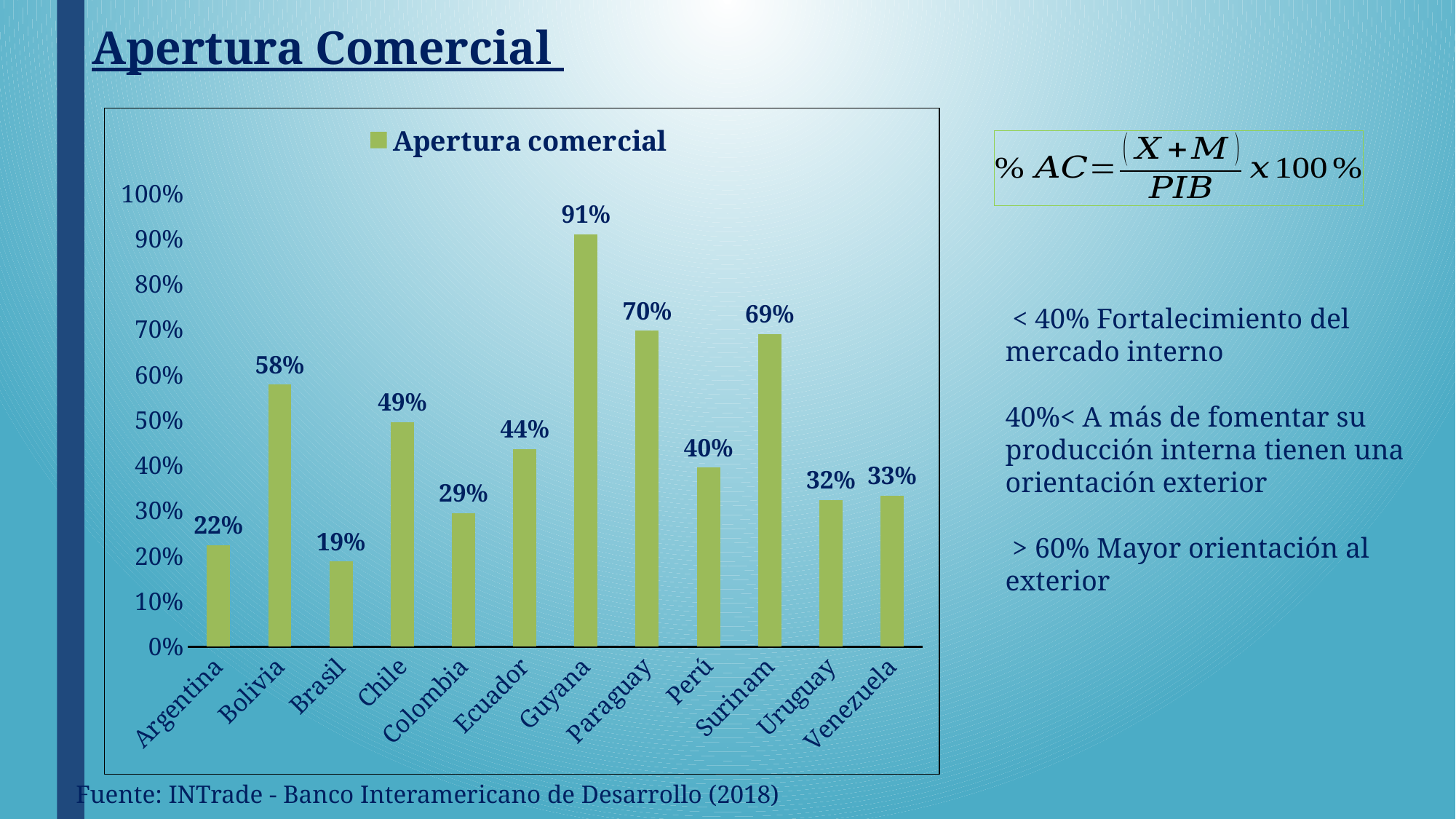
What is the value for Surinam? 69% Which is larger, the value for Paraguay or the value for Surinam? Paraguay Is the value for Ecuador greater or less than 50%? less How many series does the legend list? 1 How many countries are shown on the x axis? 12 What is the value for Guyana? 91% What is the value for Colombia? 29% What kind of chart is shown? bar chart Which country has the highest value? Guyana What is the difference between the values for Bolivia and Chile? 9% Which country has the lowest value? Brasil What is the legend entry of the chart? Apertura comercial